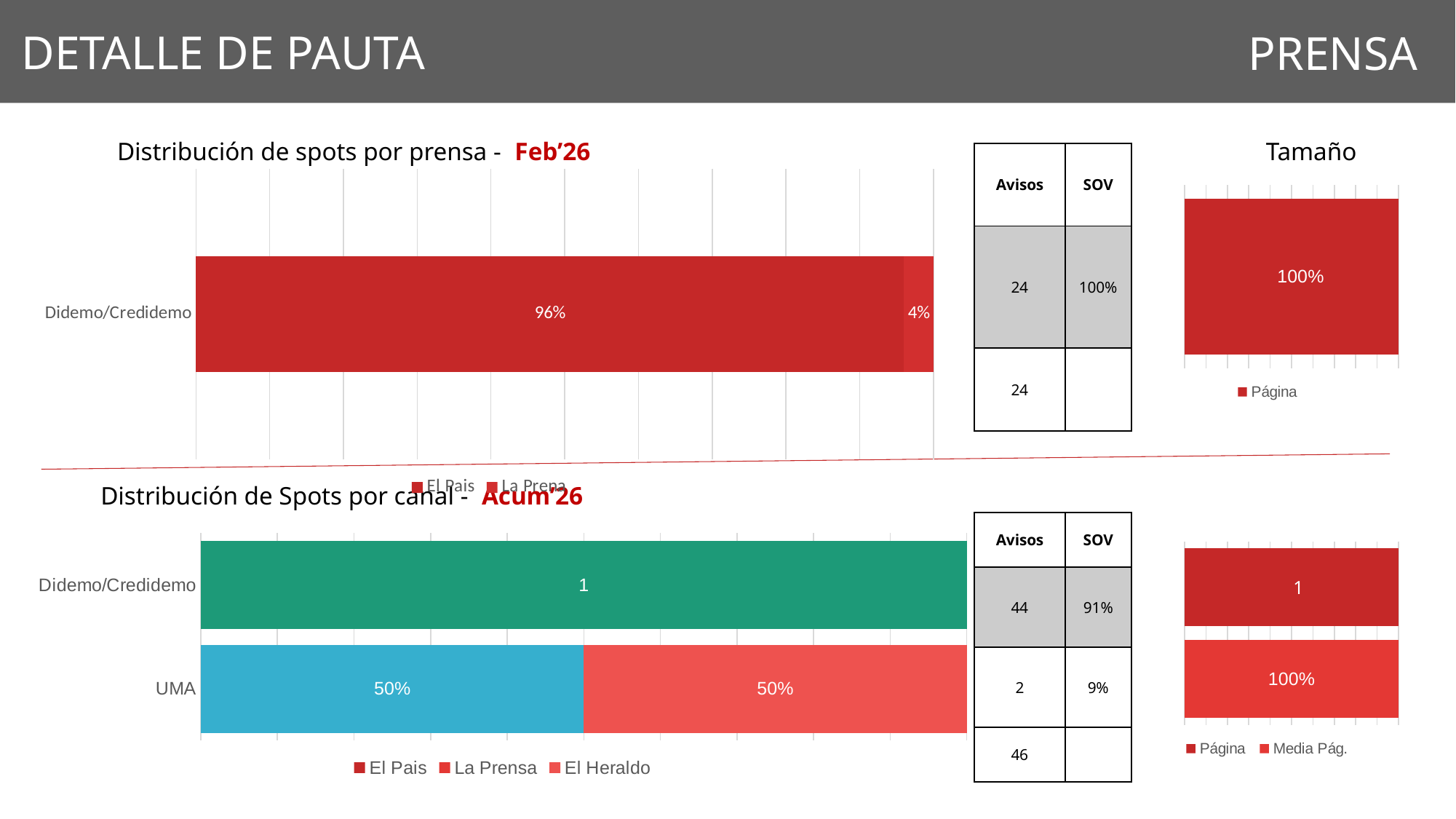
How many categories are shown on the y axis of the 'Distribución de spots por prensa - Feb'26' chart? 1 What is the only legend entry of the 'Tamaño' chart at the top right? Página In the 'Distribución de spots por prensa - Feb'26' chart, what share is labelled on the La Prensa segment for Didemo/Credidemo? 4% In the 'Distribución de spots por prensa - Feb'26' chart, what share is labelled on the El Pais segment for Didemo/Credidemo? 96% In the 'Distribución de Spots por canal - Acum'26' chart, what value is labelled on the Didemo/Credidemo bar? 1 What kind of chart is 'Distribución de spots por prensa - Feb'26'? Bar chart In the 'Distribución de spots por prensa - Feb'26' chart, what is the difference in percentage points between the El Pais and La Prensa segments? 92 percentage points How many entries does the legend of the 'Distribución de Spots por canal - Acum'26' chart list? 3 How many categories are shown on the y axis of the 'Distribución de Spots por canal - Acum'26' chart? 2 In the 'Distribución de Spots por canal - Acum'26' chart, what value is labelled on the left segment of the UMA bar? 50% In the 'Tamaño' chart at the top right, what value is labelled on the bar? 100% In the 'Distribución de spots por prensa - Feb'26' chart, which segment is larger for Didemo/Credidemo, El Pais or La Prensa? El Pais